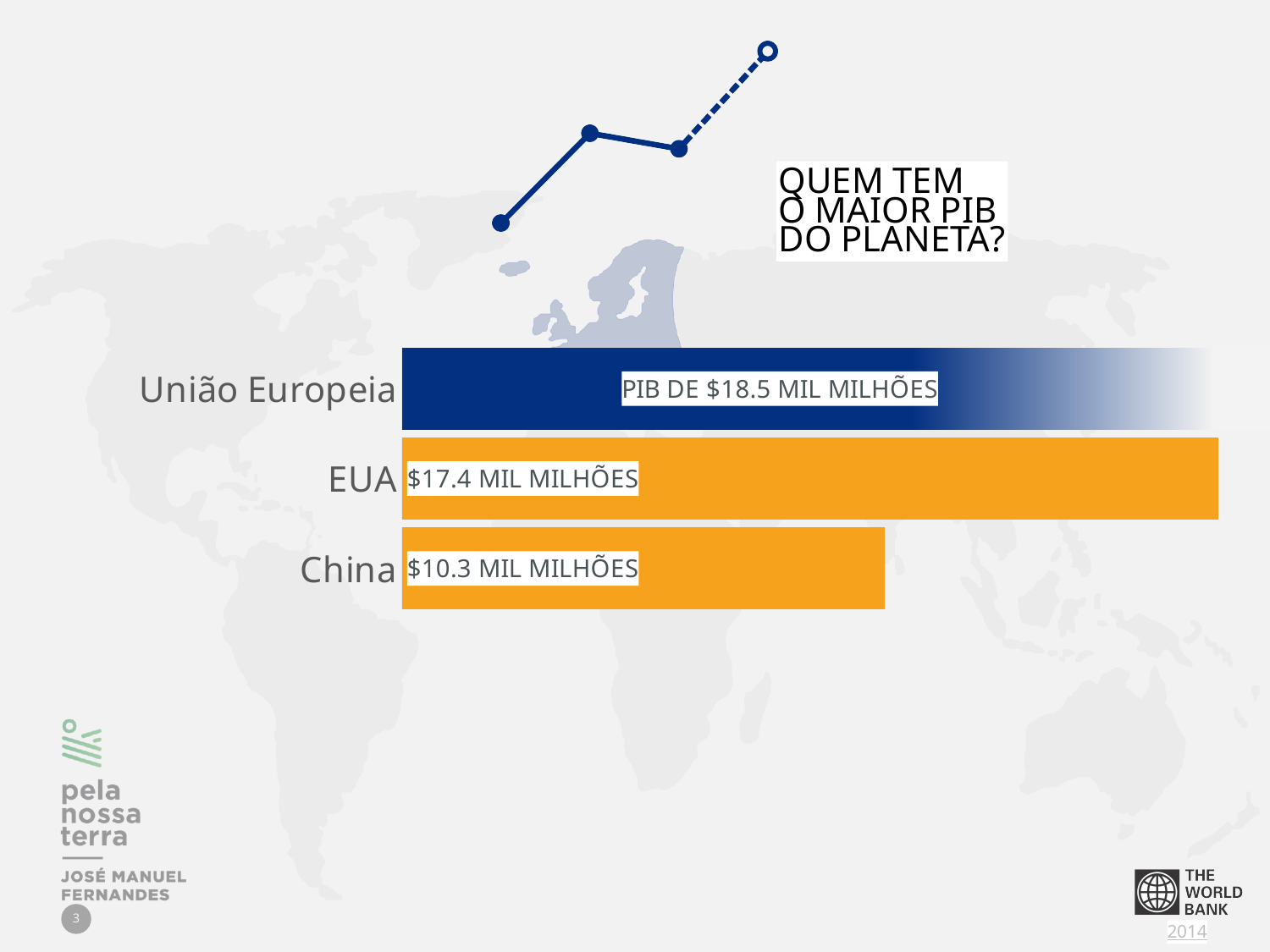
What is the GDP value shown for EUA? $17.4 mil milhões Which has a larger GDP value, EUA or China? EUA Which category has the highest GDP value on the chart? União Europeia What is the GDP value shown for União Europeia? $18.5 mil milhões Which category has the lowest GDP value on the chart? China What is the difference between the GDP values of EUA and China? $7.1 mil milhões What is the difference between the GDP values of União Europeia and EUA? $1.1 mil milhões What is the difference between the GDP values of União Europeia and China? $8.2 mil milhões How many categories are shown on the chart? 3 What is the GDP value shown for China? $10.3 mil milhões What kind of chart is shown on the slide? Bar chart What is the title question shown on the slide? QUEM TEM O MAIOR PIB DO PLANETA?